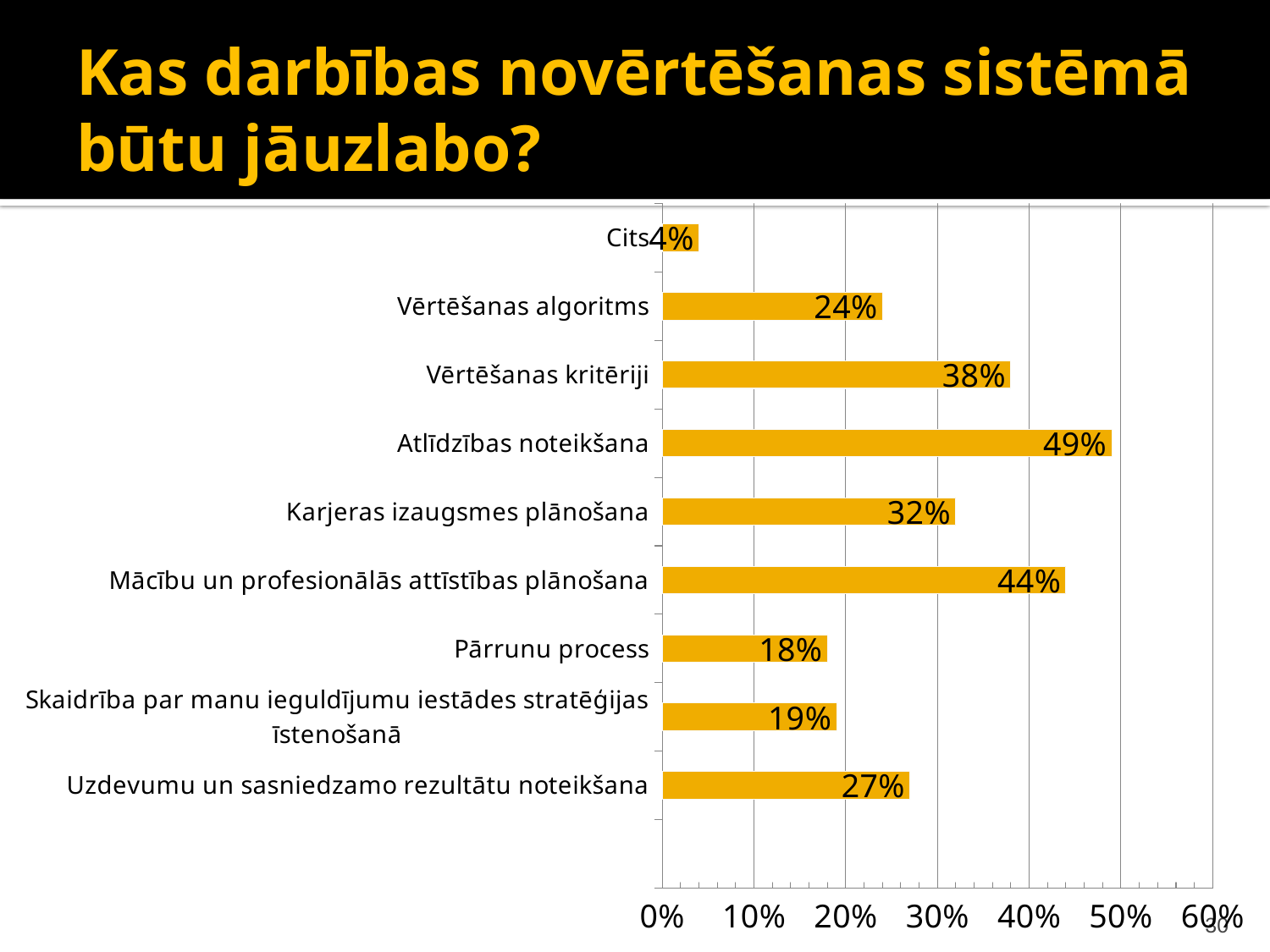
Which is larger, the value for Karjeras izaugsmes plānošana or the value for Vērtēšanas algoritms? Karjeras izaugsmes plānošana What is the value for Atlīdzības noteikšana? 49% What is the difference between the values for Atlīdzības noteikšana and Mācību un profesionālās attīstības plānošana? 5% What is the title of the slide? Kas darbības novērtēšanas sistēmā būtu jāuzlabo? Which category has the highest value? Atlīdzības noteikšana Is the value for Uzdevumu un sasniedzamo rezultātu noteikšana greater or less than 30%? less What is the value for Vērtēšanas kritēriji? 38% Which category has the lowest value? Cits What is the value for Cits? 4% What kind of chart is shown on the slide? bar chart What is the value for Pārrunu process? 18% How many categories are shown in the chart? 9